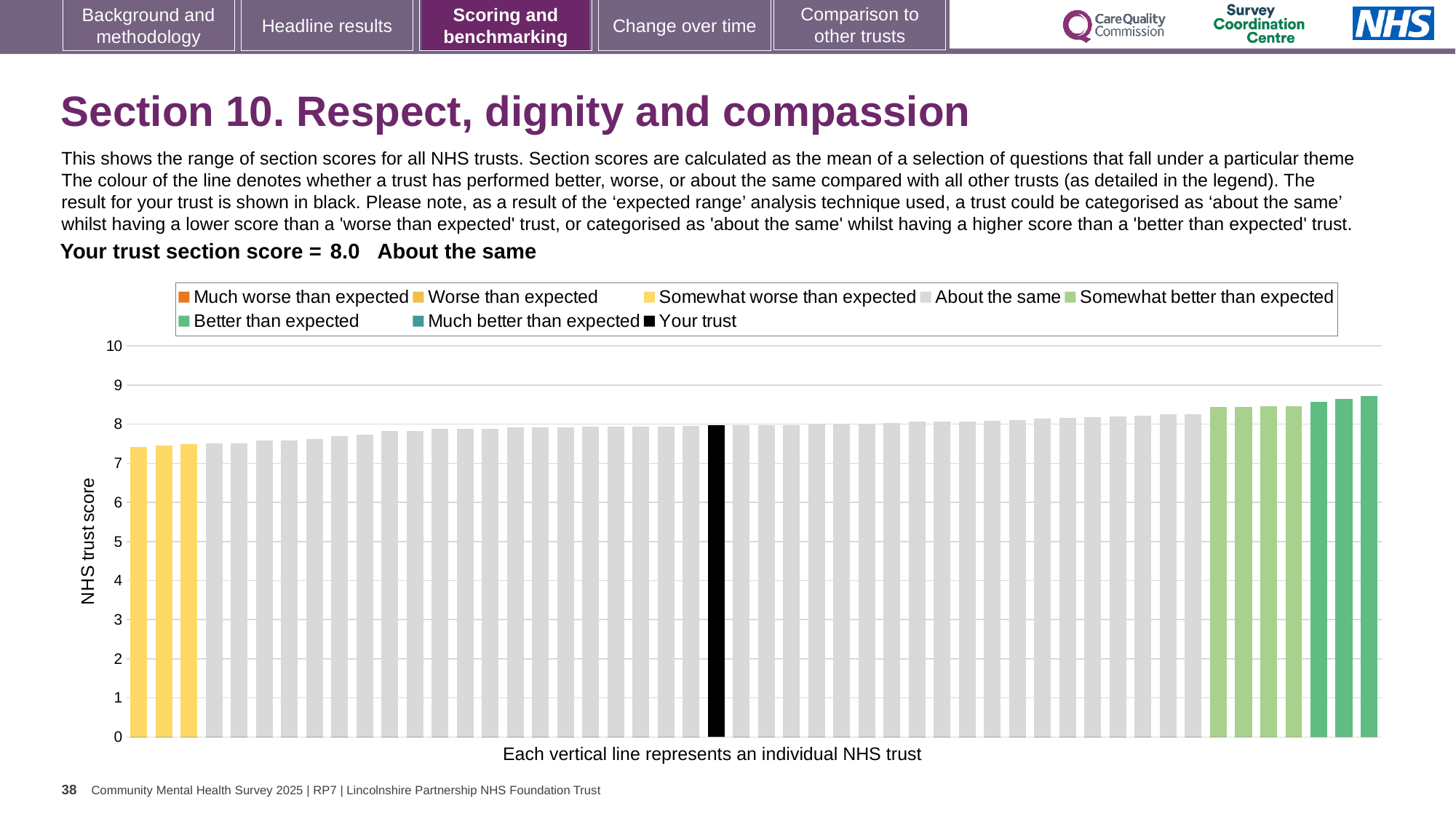
Is the leftmost bar higher or lower than the rightmost bar? lower What is the label on the vertical axis of the chart? NHS trust score What is the section score for your trust shown on the slide? 8.0 Is the value for your trust (the black bar) greater or less than 5? greater Is the value of the leftmost bar greater or less than 7? greater Is the value of the rightmost bar greater or less than 9? less Which performance category is your trust placed in? About the same What kind of chart is shown on the slide? bar chart Do the bar values rise or fall from left to right along the x axis? rise How many bars are coloured as 'Better than expected'? 3 How many bars are coloured as 'Somewhat worse than expected'? 3 How many entries does the chart legend list? 8